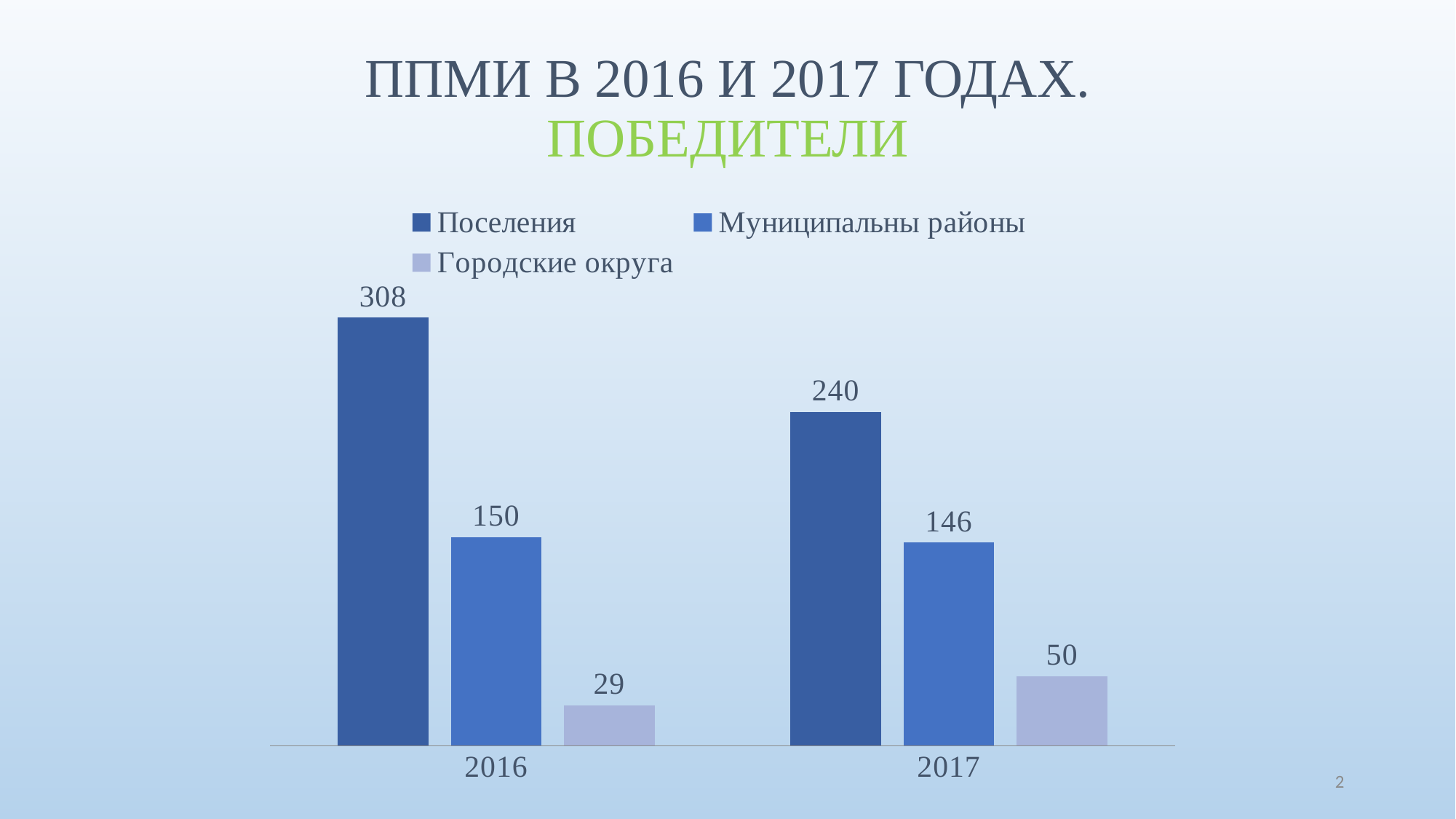
What kind of chart is shown on the slide? Bar chart What is the value for Городские округа in 2016? 29 Which series has the lowest value in 2016? Городские округа Does the value for Поселения rise or fall from 2016 to 2017? Fall What is the difference between Поселения and Муниципальны районы in 2016? 158 What is the value for Поселения in 2016? 308 What is the value for Муниципальны районы in 2017? 146 Which series has the highest value in 2017? Поселения What is the value for Городские округа in 2017? 50 Which is larger: Городские округа in 2016 or Городские округа in 2017? 2017 What is the difference between the Поселения values for 2016 and 2017? 68 How many series does the legend list? 3